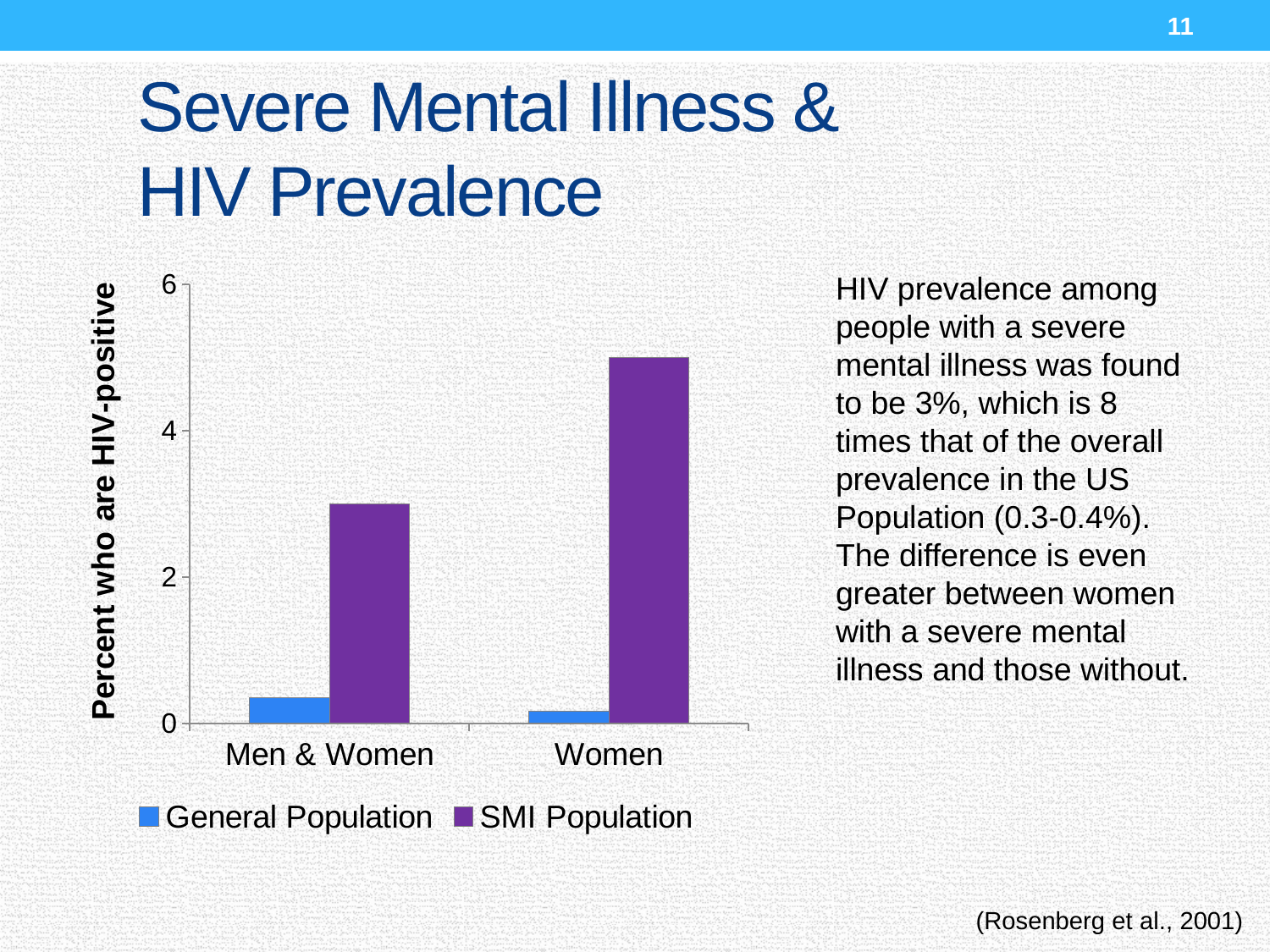
How many categories are shown on the x axis? 2 Which colour represents the SMI Population series? purple What kind of chart is shown on the slide? bar chart What is the label of the y axis? Percent who are HIV-positive Is the General Population value for Men & Women greater or less than 2? less Which bar is the shortest in the chart? General Population, Women For Women, which is larger: the General Population value or the SMI Population value? SMI Population Is the SMI Population value for Men & Women greater or less than 2? greater Is the SMI Population value for Women greater or less than 4? greater Which bar is the tallest in the chart? SMI Population, Women How many series does the legend list? 2